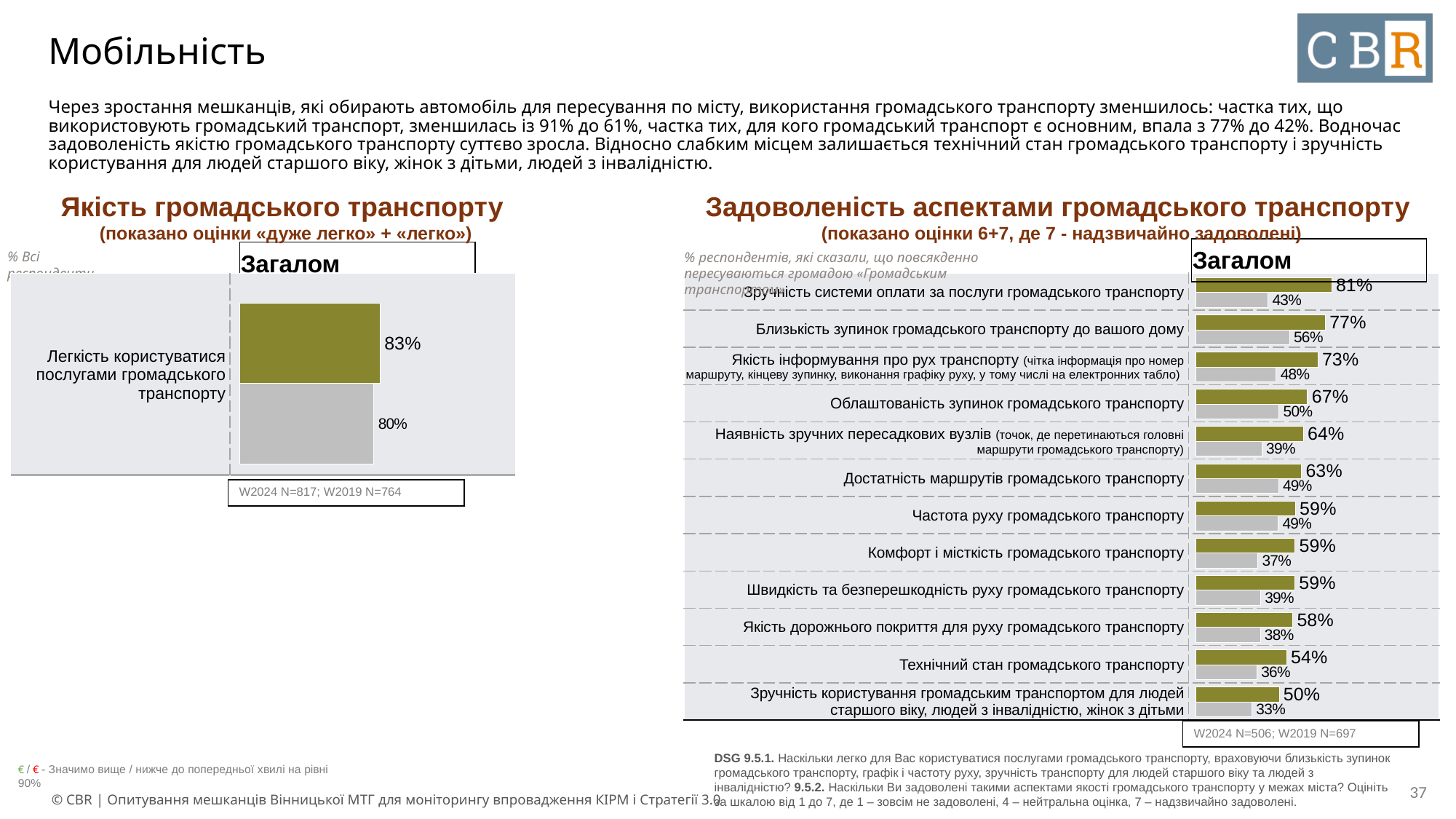
In the chart 'Якість громадського транспорту', what is the difference between the olive bar (83%) and the grey bar (80%)? 3 percentage points In the chart 'Задоволеність аспектами громадського транспорту', what is the difference between the olive and grey bars for 'Технічний стан громадського транспорту'? 18 percentage points In the chart 'Якість громадського транспорту', what value is shown on the grey bar? 80% In the chart 'Задоволеність аспектами громадського транспорту', which category has the lowest olive-bar value? Зручність користування громадським транспортом для людей старшого віку, людей з інвалідністю, жінок з дітьми In the chart 'Задоволеність аспектами громадського транспорту', what is the grey-bar value for 'Близькість зупинок громадського транспорту до вашого дому'? 56% In the chart 'Задоволеність аспектами громадського транспорту', which category has the lowest grey-bar value? Зручність користування громадським транспортом для людей старшого віку, людей з інвалідністю, жінок з дітьми In the chart 'Задоволеність аспектами громадського транспорту', which is larger: the olive-bar value for 'Частота руху громадського транспорту' or the olive-bar value for 'Облаштованість зупинок громадського транспорту'? Облаштованість зупинок громадського транспорту In the chart 'Якість громадського транспорту', what value is shown on the olive bar for 'Легкість користуватися послугами громадського транспорту'? 83% What type of chart is 'Задоволеність аспектами громадського транспорту'? Bar chart In the chart 'Задоволеність аспектами громадського транспорту', which category has the highest olive-bar value? Зручність системи оплати за послуги громадського транспорту In the chart 'Задоволеність аспектами громадського транспорту', how many categories are listed? 12 In the chart 'Задоволеність аспектами громадського транспорту', what is the olive-bar value for 'Зручність системи оплати за послуги громадського транспорту'? 81%